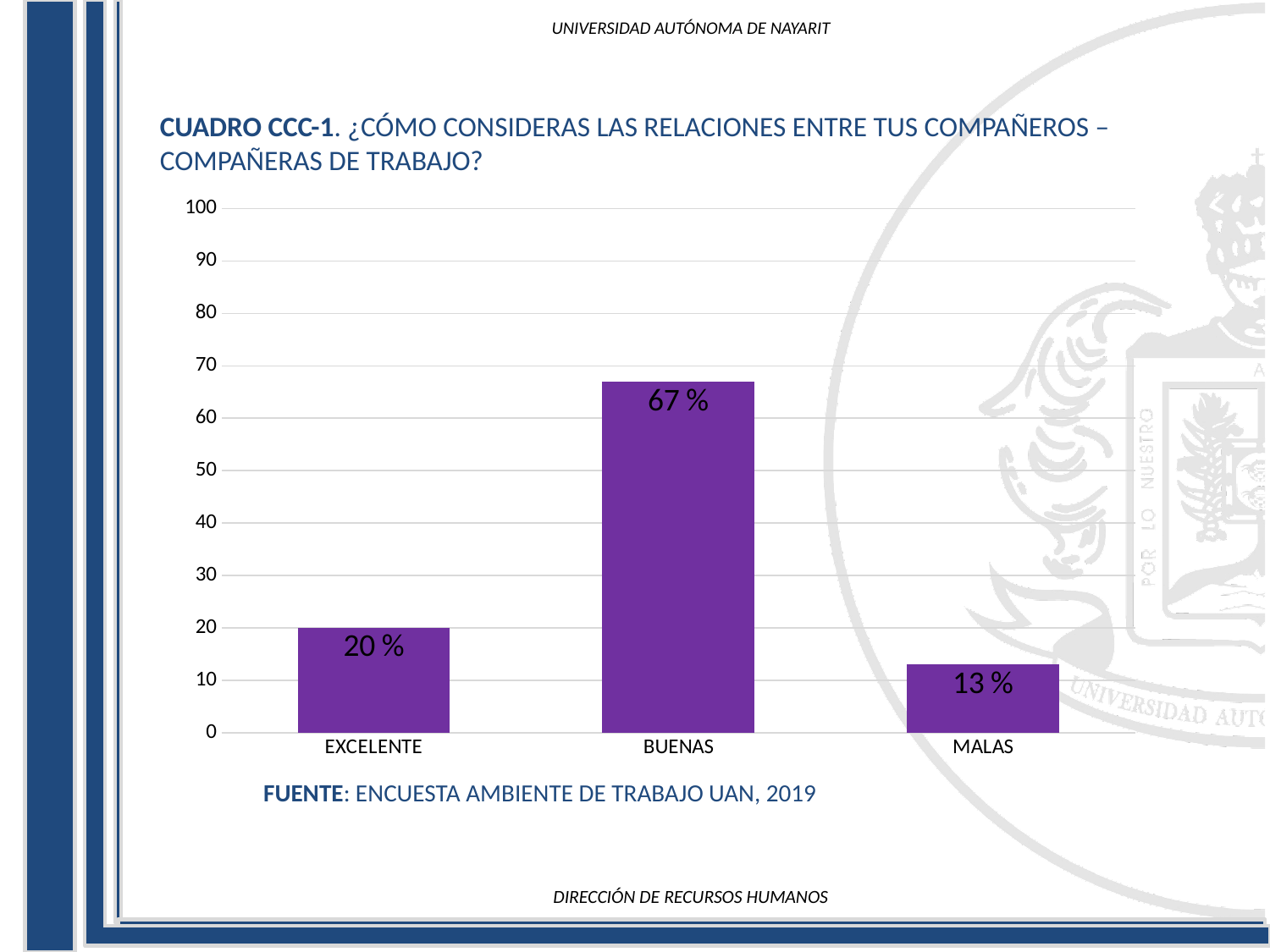
What is the difference between the values for EXCELENTE and MALAS? 7 % What is the value for EXCELENTE? 20 % What is the difference between the values for BUENAS and EXCELENTE? 47 % What kind of chart is shown on the slide? bar chart Which category has the lowest value? MALAS Which is larger, the value for EXCELENTE or the value for MALAS? EXCELENTE What source is cited below the chart? ENCUESTA AMBIENTE DE TRABAJO UAN, 2019 Is the value for BUENAS greater or less than 60? greater What is the value for MALAS? 13 % What is the value for BUENAS? 67 % How many categories are shown on the x axis? 3 Which category has the highest value? BUENAS